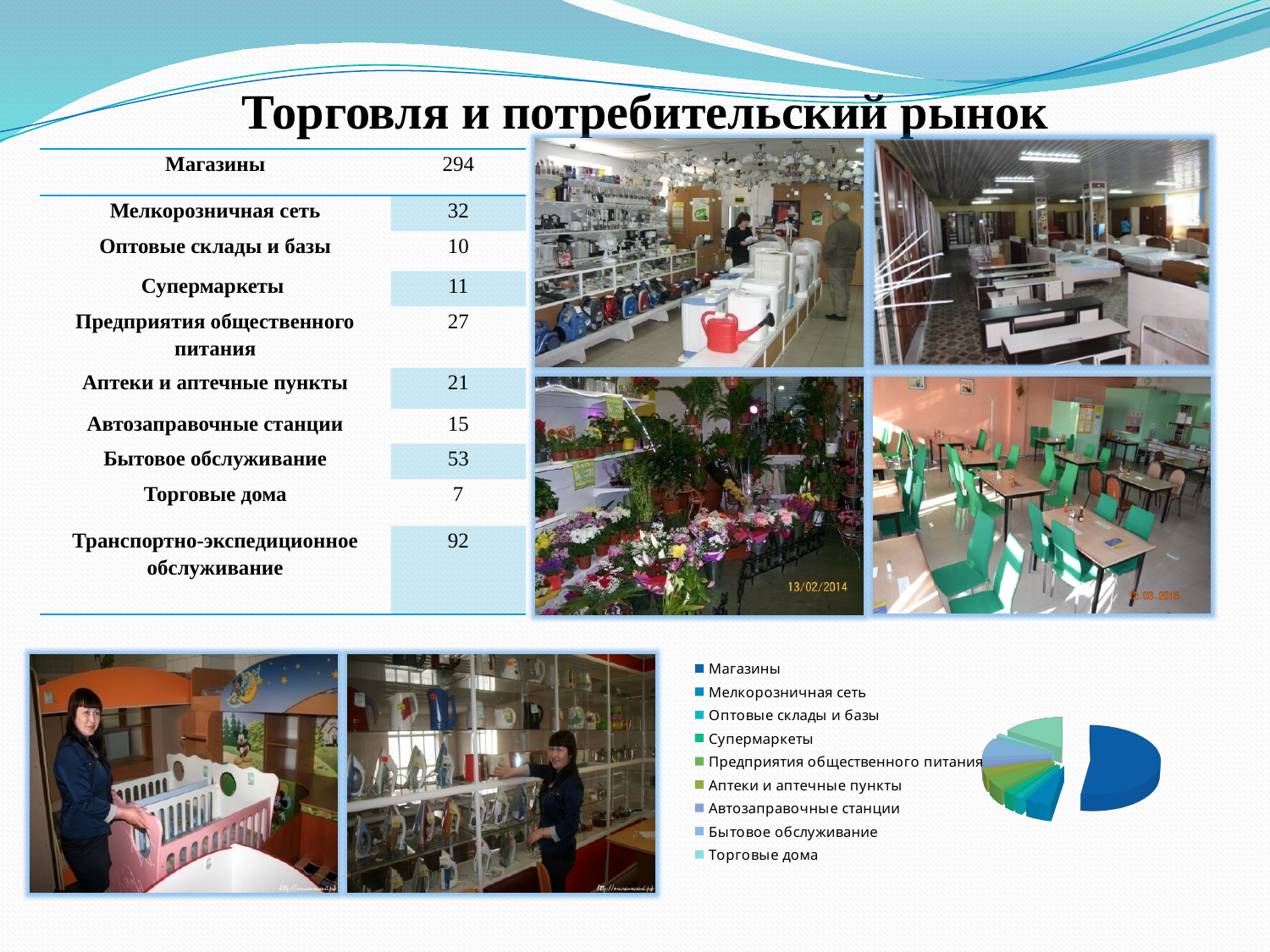
Which is larger, the value for Магазины or the value for Бытовое обслуживание? Магазины According to the table on the slide, what is the value for Магазины? 294 Which legend entry of the pie chart is listed first? Магазины According to the table on the slide, what is the value for Бытовое обслуживание? 53 How many categories does the legend of the pie chart list? 9 What is the difference between the values for Мелкорозничная сеть and Оптовые склады и базы shown in the table? 22 What is the difference between the values for Магазины and Бытовое обслуживание shown in the table? 241 What kind of chart is shown at the bottom right of the slide? pie chart Which category has the largest slice in the pie chart? Магазины According to the table on the slide, what is the value for Торговые дома? 7 According to the table on the slide, what is the value for Супермаркеты? 11 Which of the pie chart categories has the smallest value according to the table on the slide? Торговые дома